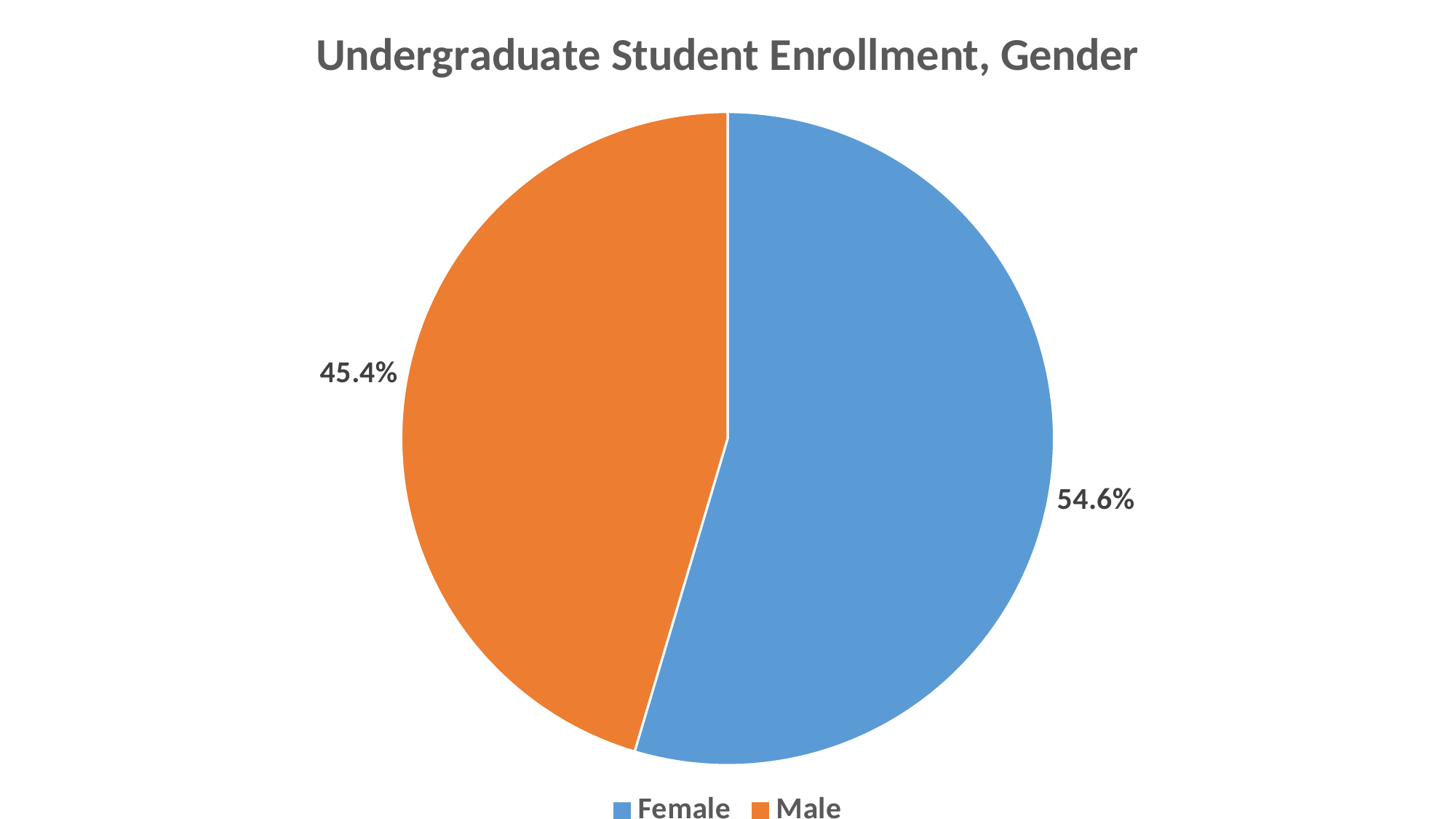
What is the difference in percentage points between the Female and Male shares? 9.2 Is the Male share greater or less than 50%? less Is the Female share larger or smaller than the Male share? larger What percentage of undergraduate student enrollment is Male? 45.4% What is the title of the chart? Undergraduate Student Enrollment, Gender What kind of chart is shown on the slide? pie chart Which gender has the larger share of undergraduate enrollment? Female Which gender has the smaller share of undergraduate enrollment? Male What colour represents Male in the pie chart? orange How many entries does the legend list? 2 How many slices does the pie chart have? 2 What percentage of undergraduate student enrollment is Female? 54.6%